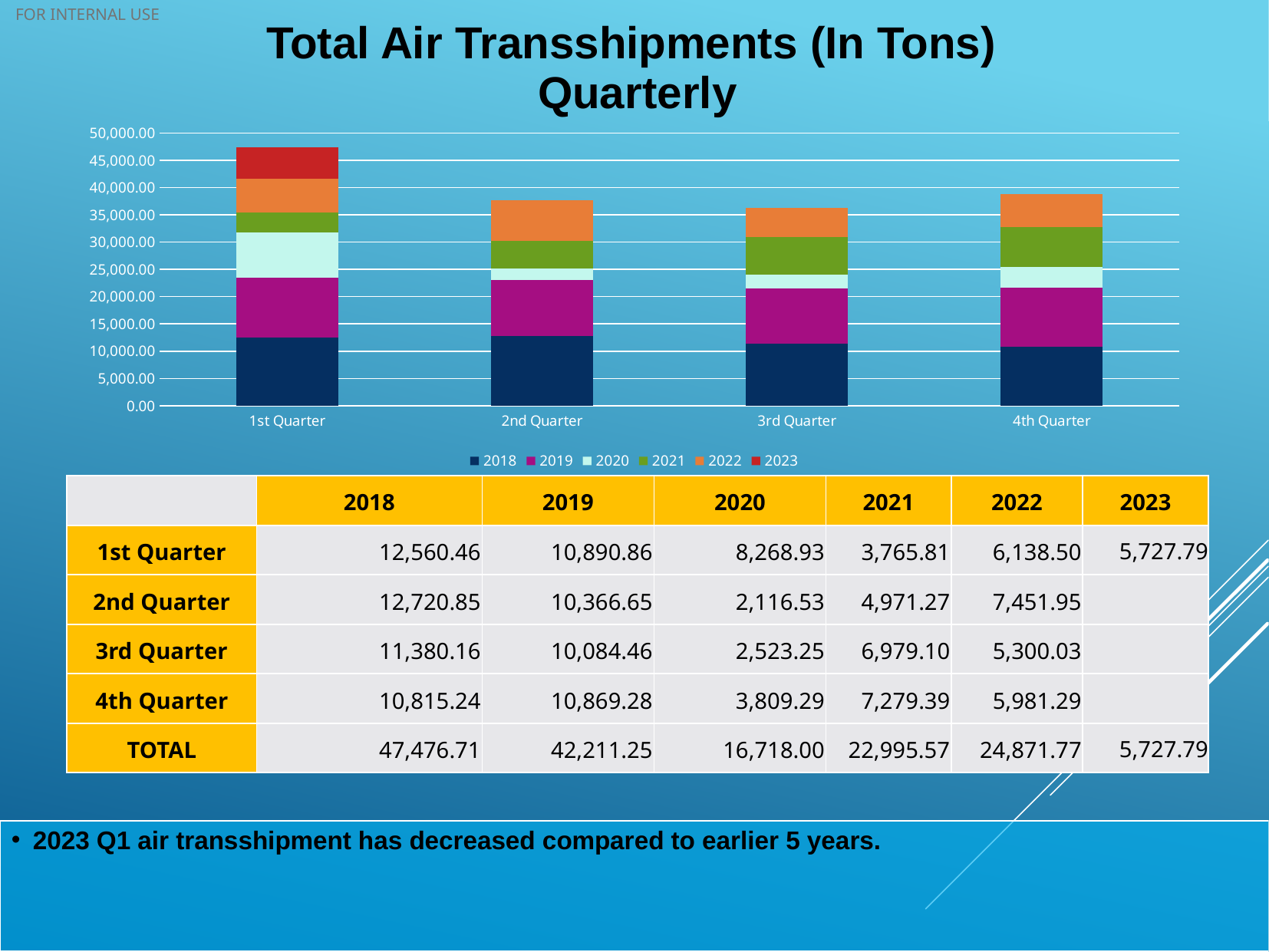
How many quarters are shown along the x axis of the chart? 4 What is the 2018 value for the 1st Quarter? 12,560.46 What kind of chart is shown on the slide? Stacked bar chart How many series does the chart legend list? 6 What is the total of the 2nd Quarter stacked bar across all years? 37,627.25 Do the 2021 values rise or fall from the 1st Quarter to the 4th Quarter? rise What is the 2022 value for the 2nd Quarter? 7,451.95 What is the difference between the 2018 values for the 2nd Quarter and the 1st Quarter? 160.39 For 2021, which is larger: the 2nd Quarter value or the 3rd Quarter value? 3rd Quarter Which quarter has the tallest stacked bar? 1st Quarter For the 2020 series, which quarter has the lowest value? 2nd Quarter Is the total height of the 1st Quarter stacked bar greater or less than 45,000.00? greater